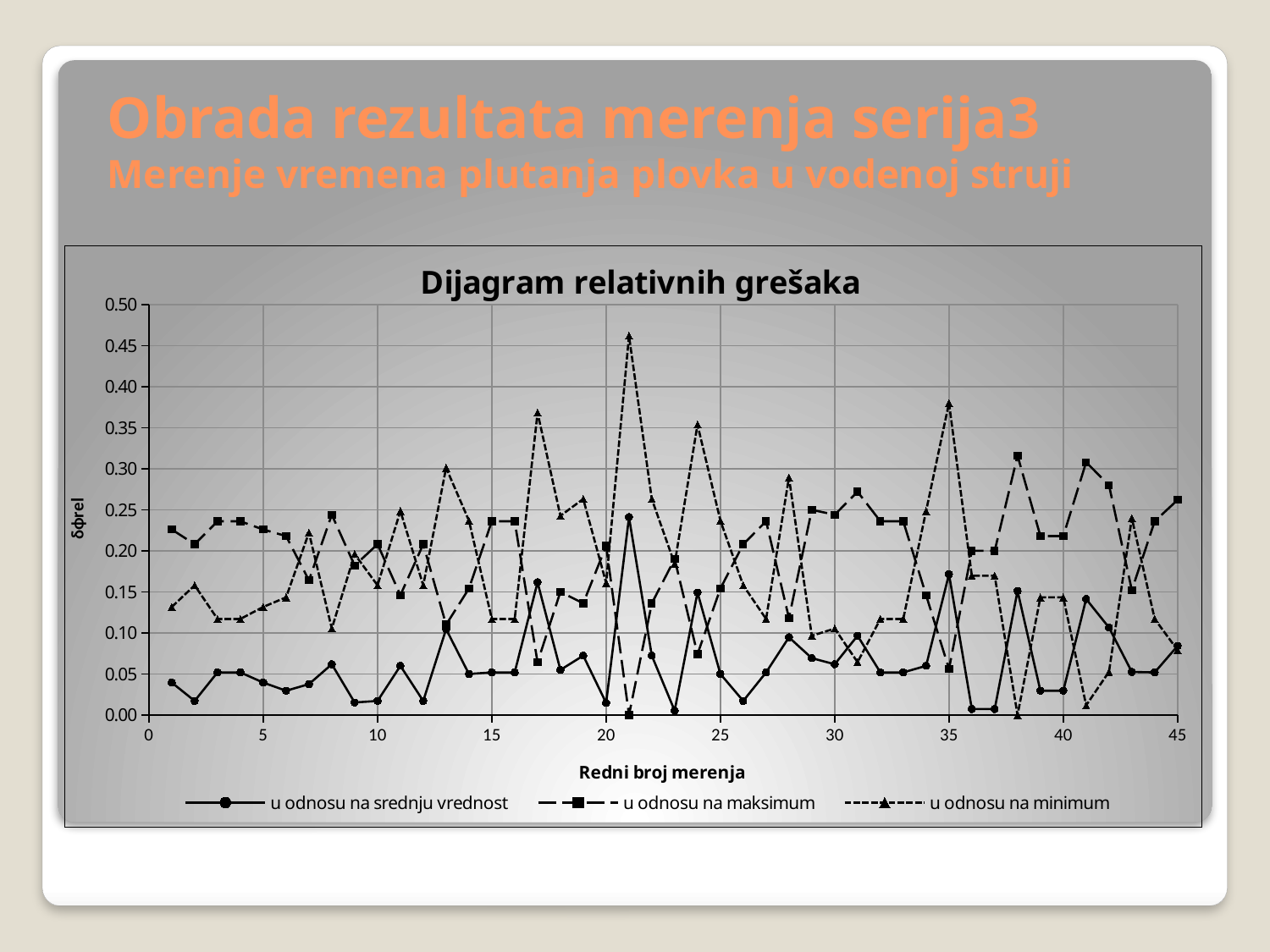
At which measurement number does the series "u odnosu na srednju vrednost" reach its highest value? 21 What is the label of the x axis? Redni broj merenja At which measurement number does the series "u odnosu na maksimum" reach its lowest value? 21 At measurement 1, which series has the larger value, "u odnosu na maksimum" or "u odnosu na minimum"? u odnosu na maksimum What is the title of the chart? Dijagram relativnih grešaka Is the value of "u odnosu na maksimum" at measurement 21 greater or less than 0.05? less At which measurement number does the series "u odnosu na minimum" reach its highest value? 21 Is the value of "u odnosu na minimum" at measurement 21 greater or less than 0.40? greater How many series does the legend list? 3 What kind of chart is shown on the slide? line chart Is the value of "u odnosu na srednju vrednost" at measurement 21 greater or less than 0.20? greater Which series reaches the highest value anywhere on the chart? u odnosu na minimum